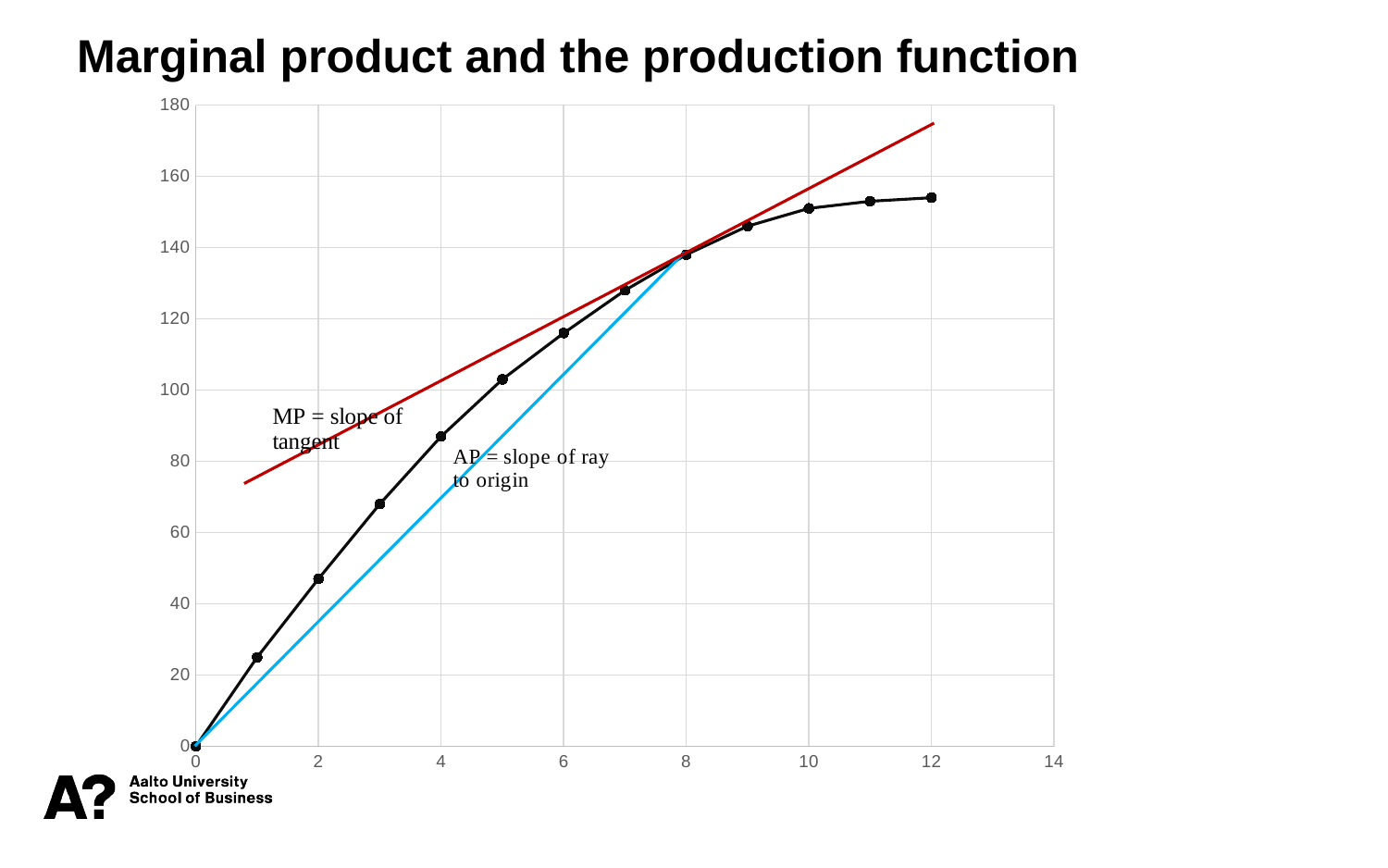
Is the value of the production function at x = 2 greater or less than 60? less How many plotted data points are on the black production function curve? 13 What kind of chart is shown on the slide? line chart Is the value of the production function at x = 4 greater or less than 80? greater Is the value of the production function at x = 6 greater or less than 100? greater At which x value is the production function lowest? 0 What does the red line on the chart represent, according to its label? MP = slope of tangent At which x value is the production function highest? 12 Do the values of the production function rise or fall as x increases from 0 to 12? rise What is the title of the slide containing the chart? Marginal product and the production function